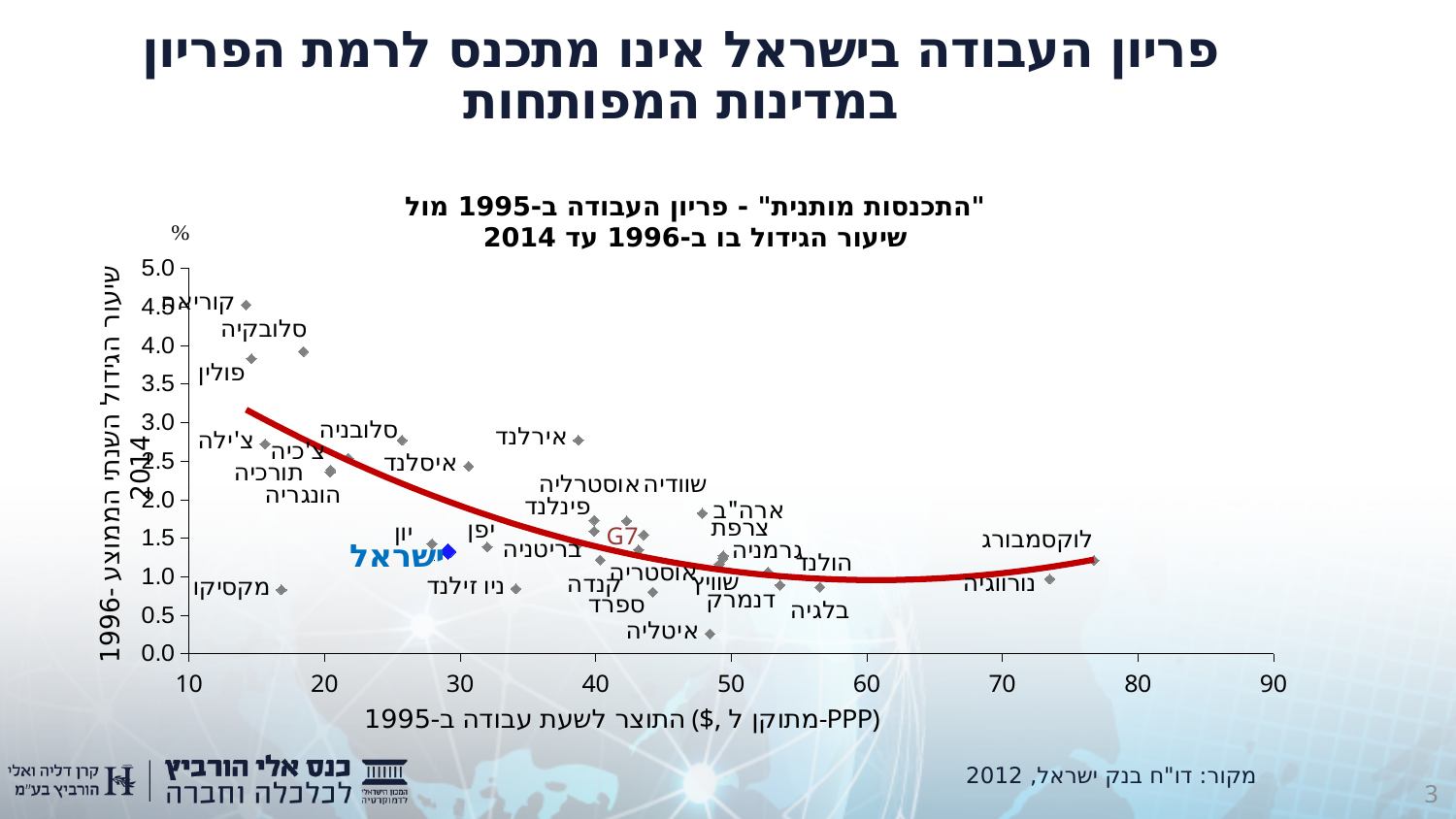
Is the horizontal-axis value for לוקסמבורג (Luxembourg) greater or less than 70? greater As the horizontal-axis value increases from 10 to 60, does the red trend line rise or fall? fall What is the label of the horizontal axis? התוצר לשעת עבודה ב-1995 ($, מתוקן ל-PPP) Which country has the highest value on the vertical axis (average annual growth rate 1996-2014)? קוריאה (Korea) Is the vertical-axis value for ישראל (Israel) greater or less than 1.5? less Which country is furthest to the right on the horizontal axis (highest labor productivity in 1995)? לוקסמבורג (Luxembourg) Which country is furthest to the left on the horizontal axis? קוריאה (Korea) Is the vertical-axis value for קוריאה (Korea) greater or less than 4.0? greater What kind of chart is shown on the slide? scatter chart Which country has the lowest value on the vertical axis? איטליה (Italy) Which has the higher vertical-axis value, אירלנד (Ireland) or ישראל (Israel)? אירלנד (Ireland)